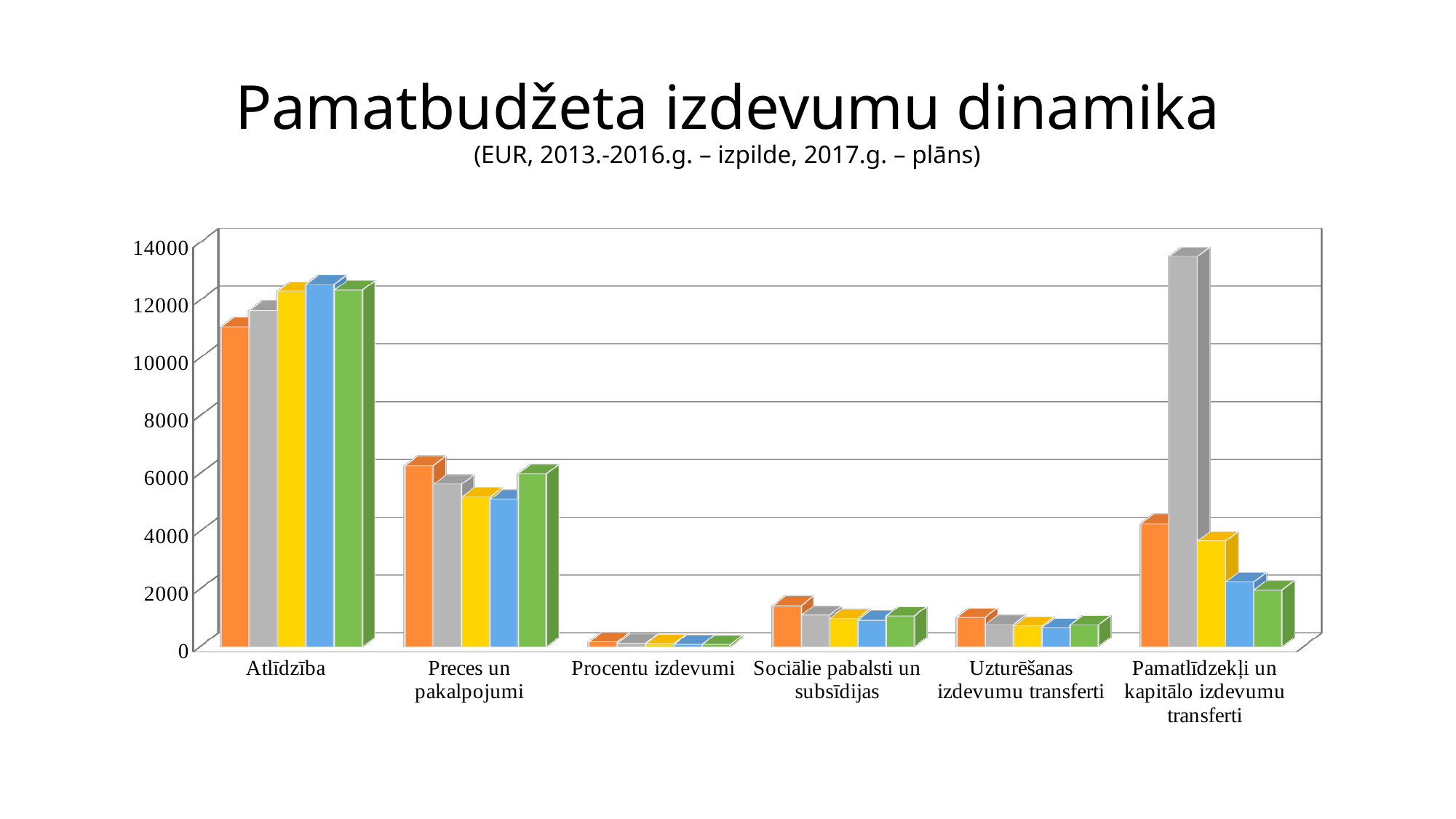
Is the value of the tallest bar for Pamatlīdzekļi un kapitālo izdevumu transferti greater or less than 12000? greater What kind of chart is shown on the slide? bar chart Are the values for Procentu izdevumi greater or less than 2000? less Which category has the lowest values across all its bars? Procentu izdevumi What is the title of the chart on the slide? Pamatbudžeta izdevumu dinamika How many bars are plotted for each category in the chart? 5 For Pamatlīdzekļi un kapitālo izdevumu transferti, which is larger, the gray bar or the orange bar? the gray bar Which category has larger values, Atlīdzība or Preces un pakalpojumi? Atlīdzība Are the values for Atlīdzība greater or less than 10000? greater How many categories are shown on the x axis of the chart? 6 Which category contains the single tallest bar in the chart? Pamatlīdzekļi un kapitālo izdevumu transferti